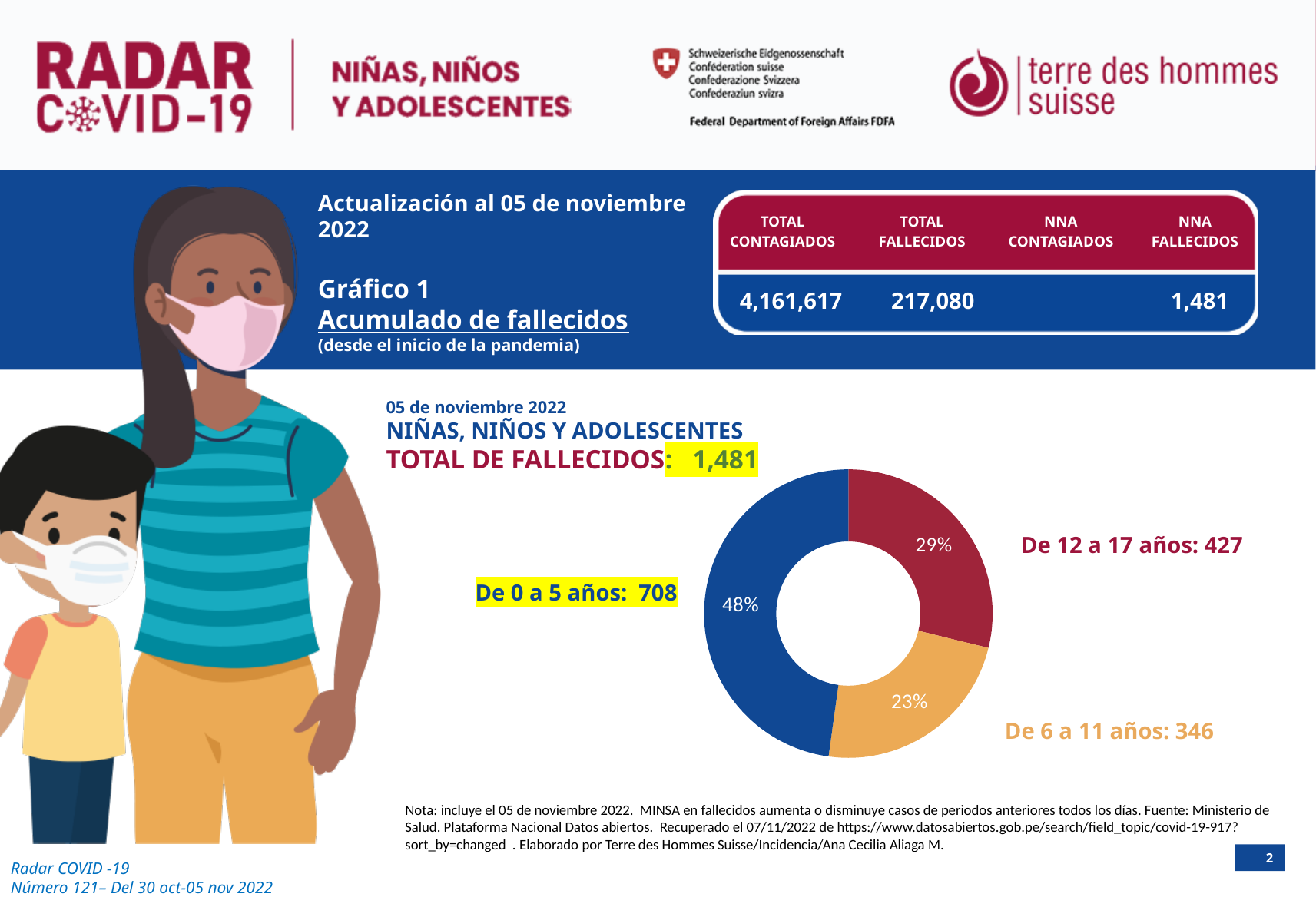
What is the number of deaths for the 'De 6 a 11 años' group? 346 What is the number of deaths for the 'De 12 a 17 años' group? 427 How many age groups are shown in the donut chart? 3 What kind of chart is shown on the slide? Donut (pie) chart What is the number of deaths for the 'De 0 a 5 años' group? 708 What percentage of the donut chart does the 'De 12 a 17 años' group represent? 29% What is the difference in deaths between the 'De 0 a 5 años' group and the 'De 12 a 17 años' group? 281 What is the total number of deaths shown above the donut chart for niñas, niños y adolescentes? 1,481 Which age group has the smallest share of the donut chart? De 6 a 11 años Which age group has the largest share of the donut chart? De 0 a 5 años What percentage of the donut chart does the 'De 0 a 5 años' group represent? 48% Which group has more deaths, 'De 6 a 11 años' or 'De 12 a 17 años'? De 12 a 17 años